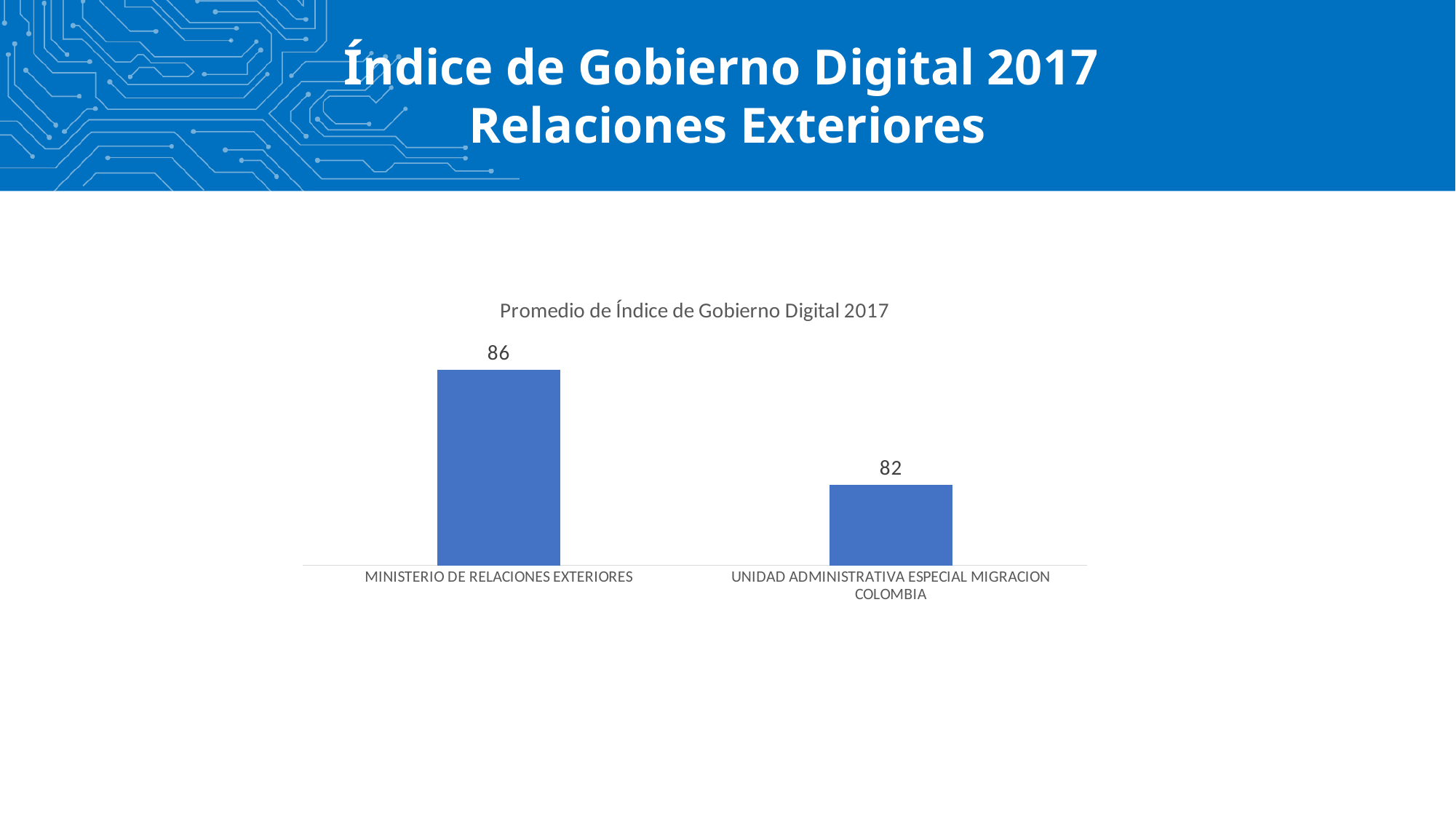
What is the title of the chart? Promedio de Índice de Gobierno Digital 2017 What colour are the bars in the chart? Blue Which category has the highest value? MINISTERIO DE RELACIONES EXTERIORES What kind of chart is shown on the slide? Bar chart What is the value for MINISTERIO DE RELACIONES EXTERIORES? 86 What is the value for UNIDAD ADMINISTRATIVA ESPECIAL MIGRACION COLOMBIA? 82 Which is larger, the value for MINISTERIO DE RELACIONES EXTERIORES or the value for UNIDAD ADMINISTRATIVA ESPECIAL MIGRACION COLOMBIA? MINISTERIO DE RELACIONES EXTERIORES Do the values rise or fall from left to right across the categories? Fall How many categories are shown in the chart? 2 Which category has the lowest value? UNIDAD ADMINISTRATIVA ESPECIAL MIGRACION COLOMBIA What is the difference between the values for MINISTERIO DE RELACIONES EXTERIORES and UNIDAD ADMINISTRATIVA ESPECIAL MIGRACION COLOMBIA? 4